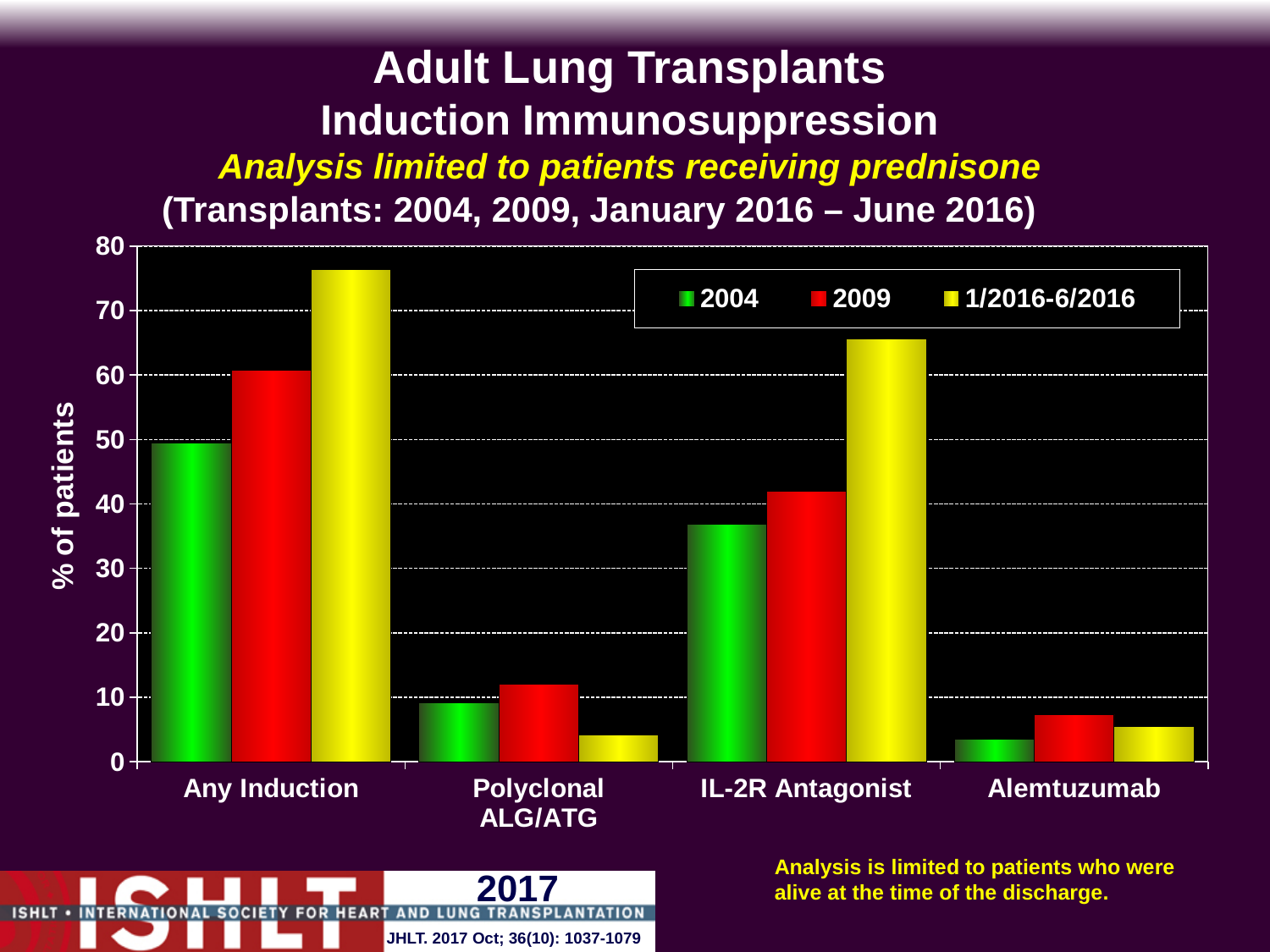
Is the value for Polyclonal ALG/ATG in 2009 greater or less than 10? greater Which category has the highest value for the 1/2016-6/2016 series? Any Induction For Polyclonal ALG/ATG, which series has the larger value: 2004 or 1/2016-6/2016? 2004 For IL-2R Antagonist, which series has the larger value: 2009 or 1/2016-6/2016? 1/2016-6/2016 Which category has the lowest value for the 2004 series? Alemtuzumab Is the value for Any Induction in 1/2016-6/2016 greater or less than 70? greater Is the value for IL-2R Antagonist in 2004 greater or less than 40? less How many series does the legend list? 3 What colour represents the 2009 series in the legend? red What kind of chart is shown on the slide? bar chart How many induction categories are shown on the x axis? 4